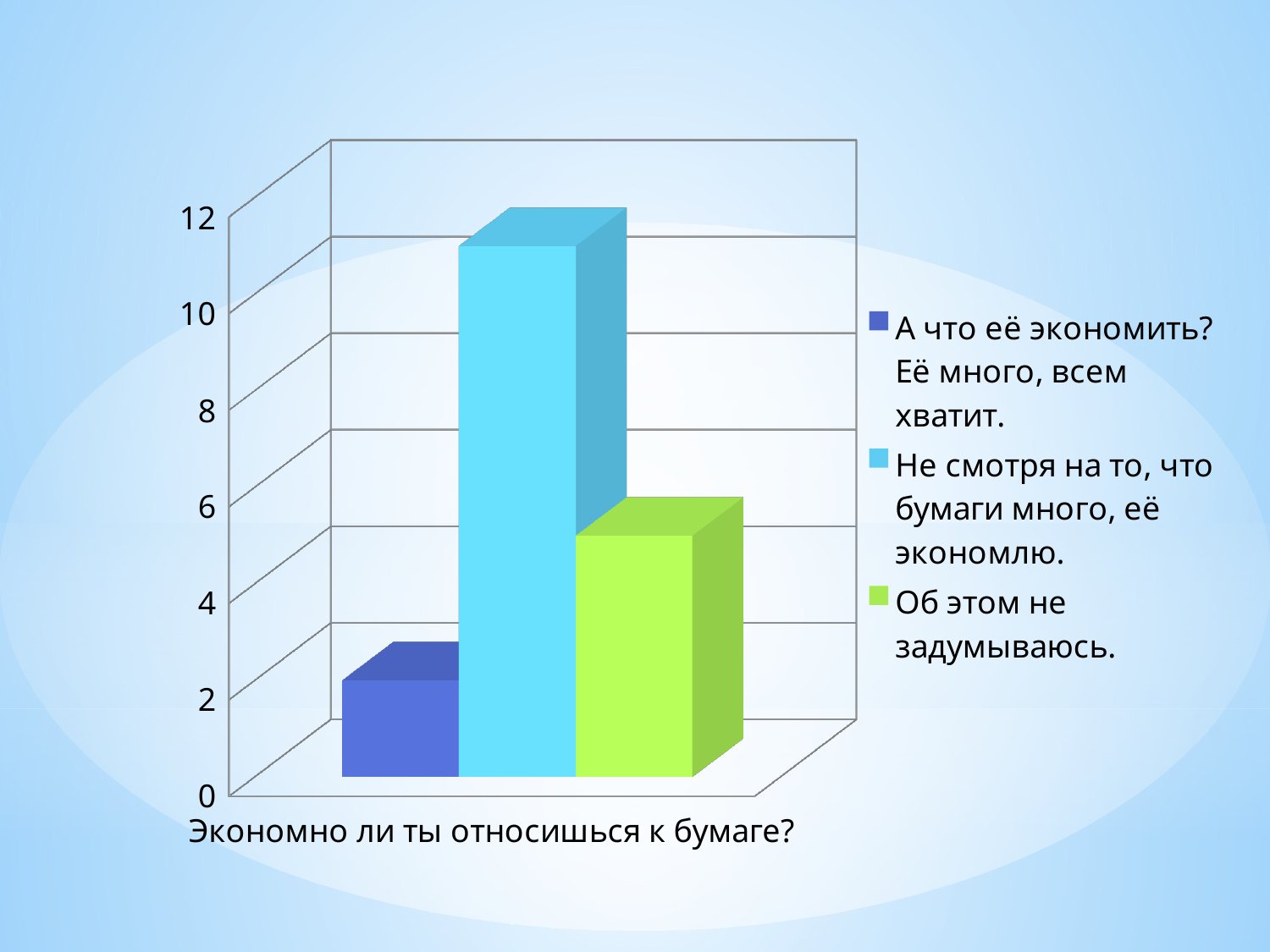
Is the value for "Об этом не задумываюсь." greater or less than 8? less Is the value for "Не смотря на то, что бумаги много, её экономлю." greater or less than 8? greater Is the value for "А что её экономить? Её много, всем хватит." greater or less than 4? less How many series does the legend list? 3 What kind of chart is shown on the slide? bar chart What colour is the bar for "Об этом не задумываюсь."? green Which series has the highest bar? Не смотря на то, что бумаги много, её экономлю. Which is larger: the bar for "Не смотря на то, что бумаги много, её экономлю." or the bar for "Об этом не задумываюсь."? Не смотря на то, что бумаги много, её экономлю. How many categories are shown on the x axis? 1 Which series has the lowest bar? А что её экономить? Её много, всем хватит. Which is larger: the bar for "Об этом не задумываюсь." or the bar for "А что её экономить? Её много, всем хватит."? Об этом не задумываюсь. What is the category label shown under the x axis? Экономно ли ты относишься к бумаге?